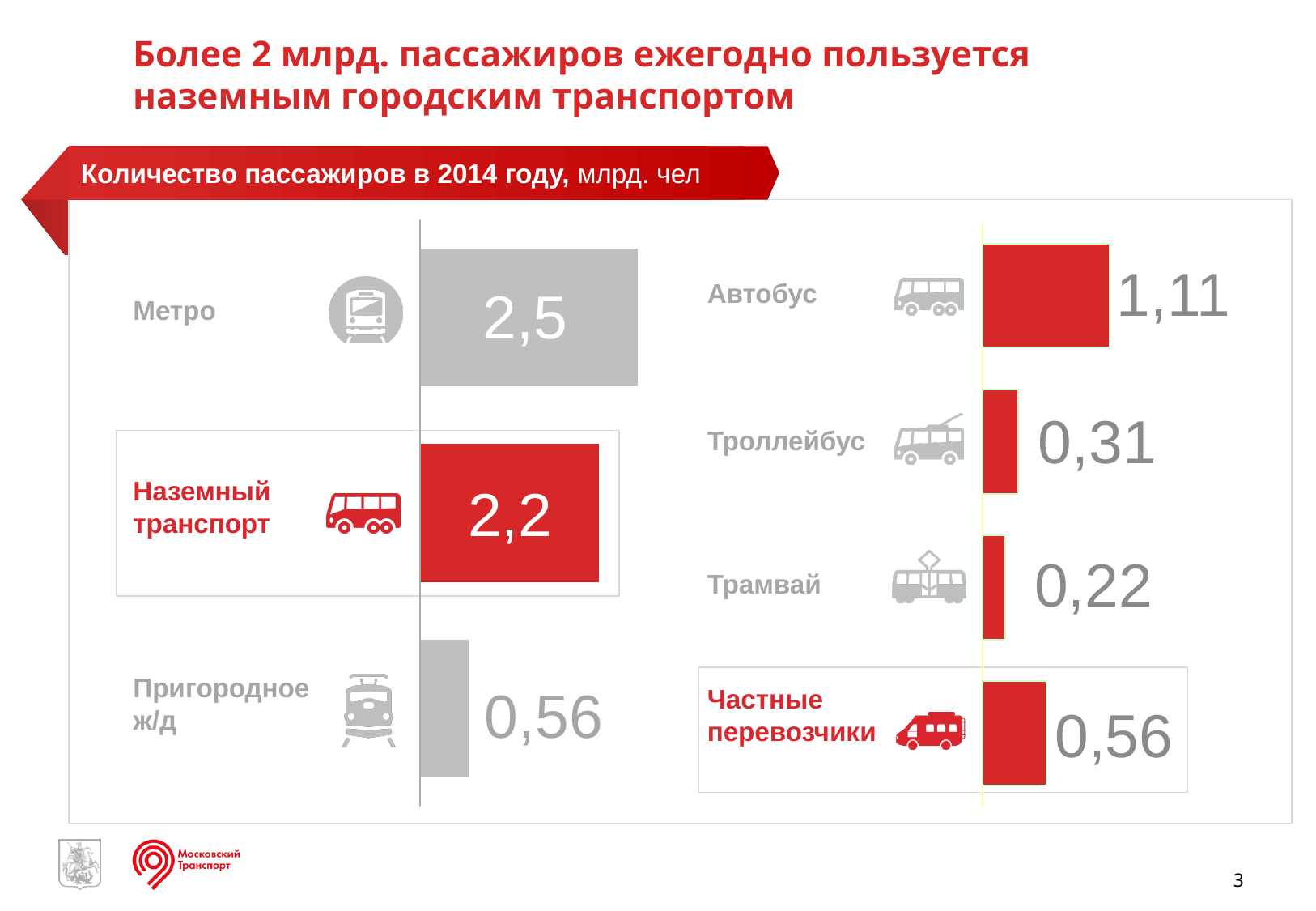
On the right chart, which category has the lowest value? Трамвай On the right chart, which is larger: the value for Троллейбус or the value for Частные перевозчики? Частные перевозчики On the right chart, which category has the highest value? Автобус On the left chart, what is the difference between the values for Метро and Наземный транспорт? 0,3 On the left chart, what is the value for Метро? 2,5 On the left chart, what is the value for Пригородное ж/д? 0,56 On the left chart, what is the value for Наземный транспорт? 2,2 On the right chart, what is the value for Автобус? 1,11 On the left chart, which category has the lowest value? Пригородное ж/д On the right chart, what is the value for Трамвай? 0,22 How many categories are shown on the right chart? 4 What kind of chart is the left chart? Bar chart